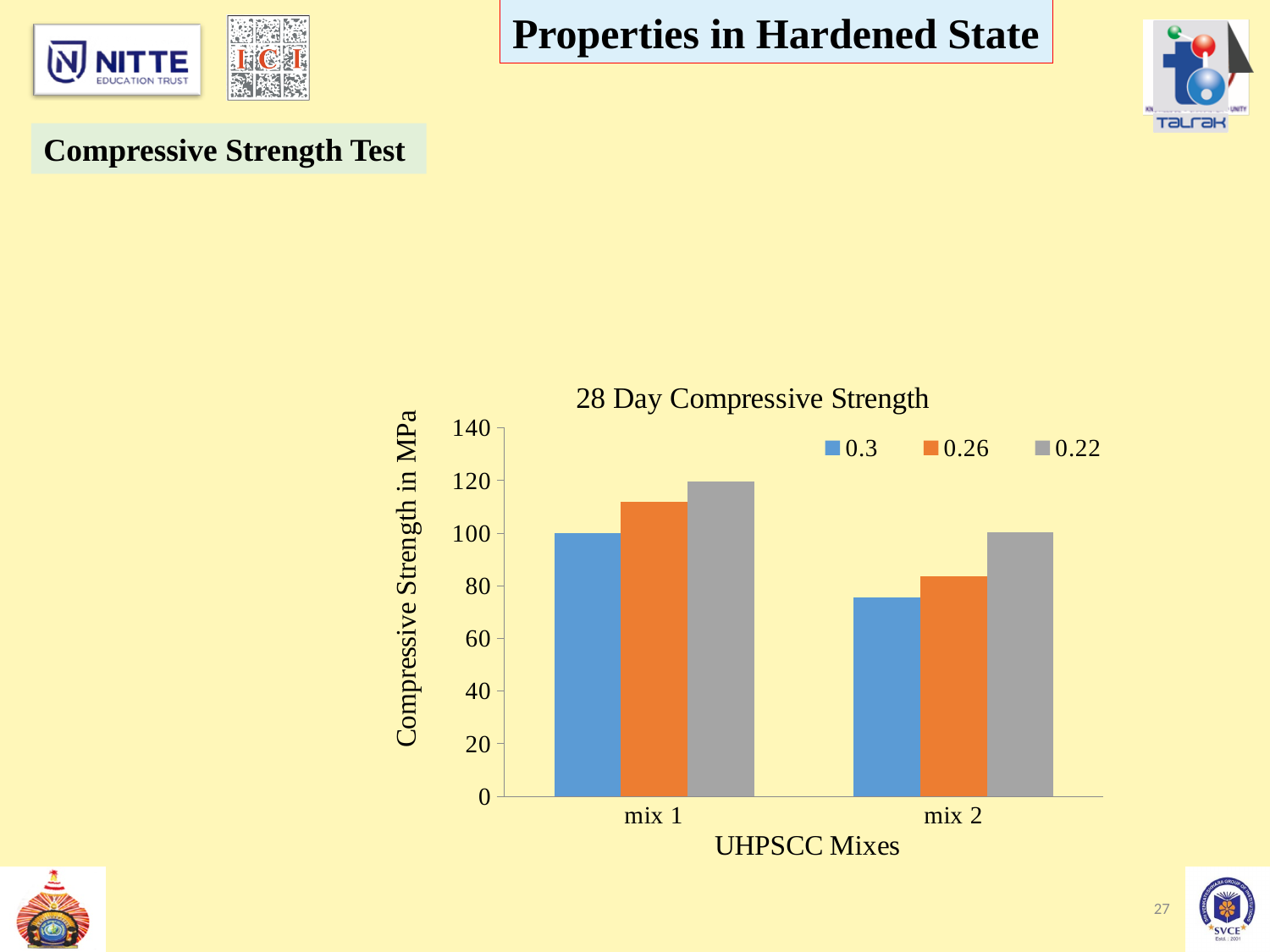
How many mixes are shown on the x axis of the chart? 2 What kind of chart is shown on the slide? bar chart How many series does the legend of the chart list? 3 What is the label of the y axis of the chart? Compressive Strength in MPa Is the value for the 0.3 series at mix 2 greater or less than 80? less For the 0.26 series, which mix has the larger compressive strength, mix 1 or mix 2? mix 1 Is the value for the 0.22 series at mix 1 greater or less than 110? greater For mix 2, which series has the lowest compressive strength? 0.3 Do the compressive strength values rise or fall from mix 1 to mix 2 for each series? fall For mix 1, which series has the highest compressive strength? 0.22 What is the title of the chart? 28 Day Compressive Strength